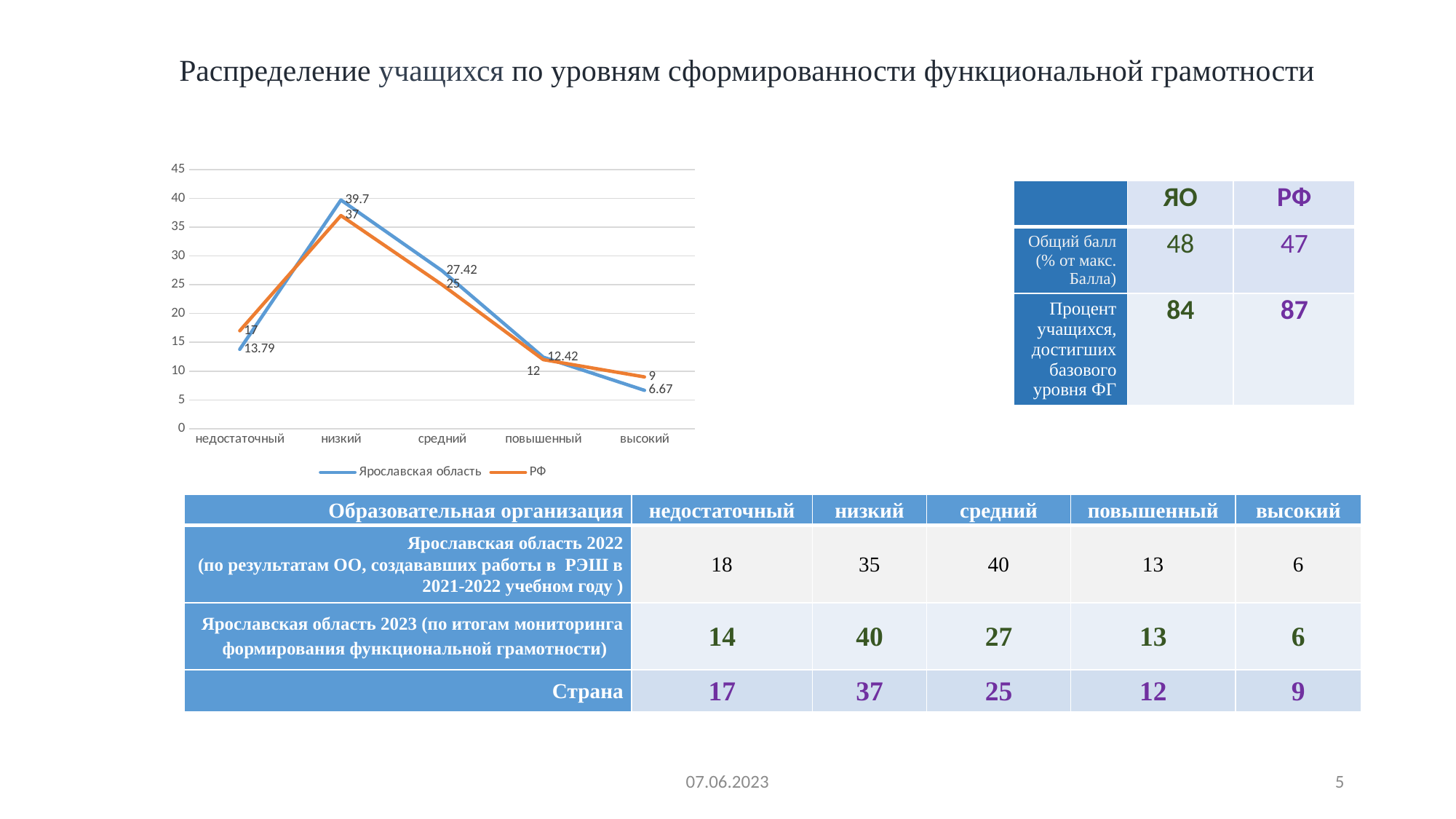
How many series does the chart legend list? 2 At the недостаточный level, which series has the larger value, Ярославская область or РФ? РФ Which level has the lowest value for the Ярославская область series? высокий Which level has the highest value for the РФ series? низкий What is the value for Ярославская область at the низкий level? 39.7 What type of chart is shown on the slide? line chart Which colour is used for the Ярославская область line in the chart? blue Do the values for РФ rise or fall from the низкий level to the высокий level? fall What is the value for РФ at the недостаточный level? 17 What is the difference between Ярославская область and РФ at the средний level? 2.42 How many categories are shown on the x axis of the chart? 5 What is the value for Ярославская область at the высокий level? 6.67